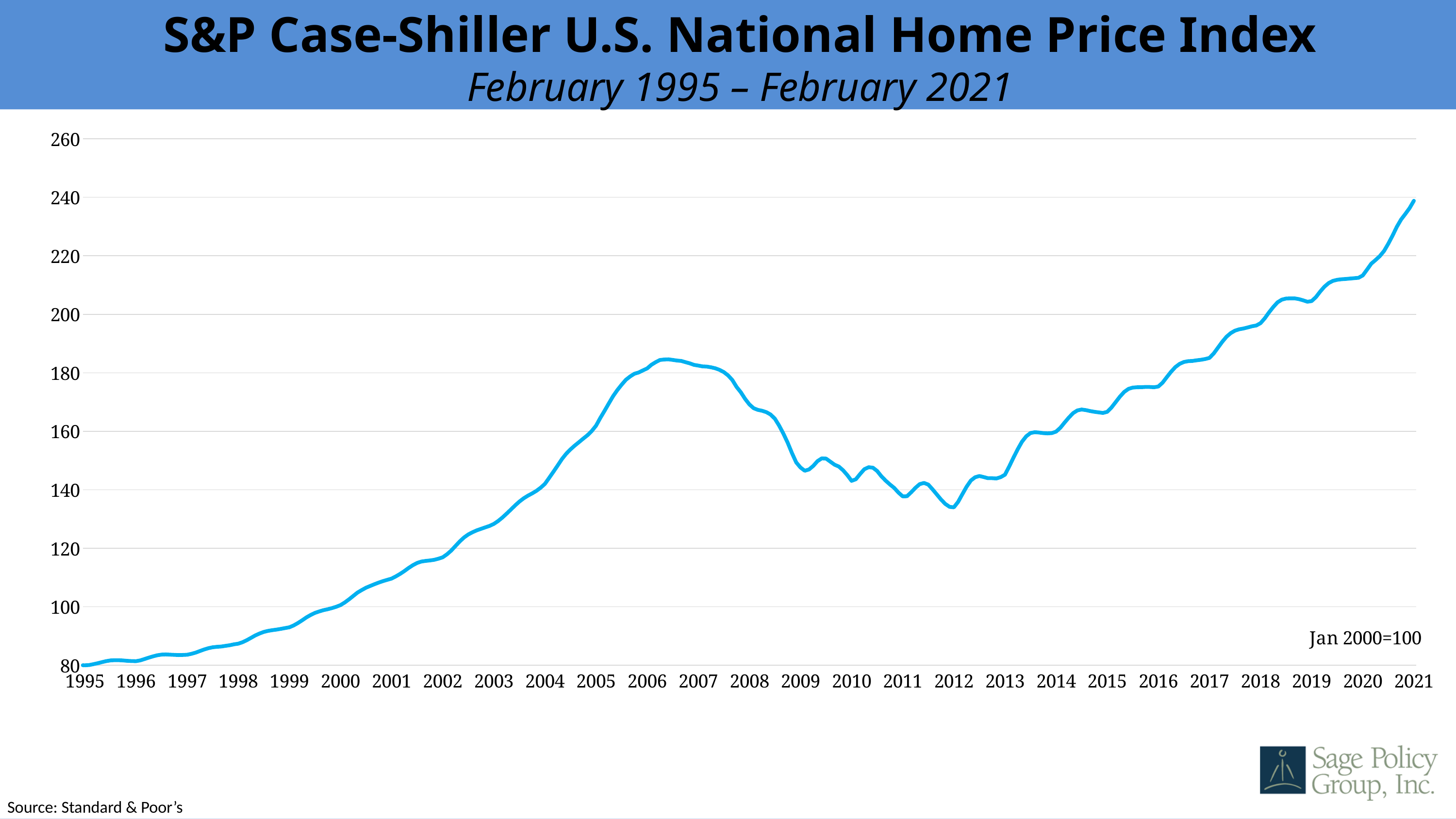
Does the index rise or fall between 2012 and 2021? Rise What is the title of the chart? S&P Case-Shiller U.S. National Home Price Index Is the value of the index at 1995 greater or less than 100? less What is the source cited for the chart? Standard & Poor's What kind of chart is shown on the slide? Line chart Is the value of the index at 2006 greater or less than 160? greater Is the value of the index at 2012 greater or less than 140? less Does the index rise or fall between 2007 and 2012? Fall Is the index higher at 2021 or at 2006? 2021